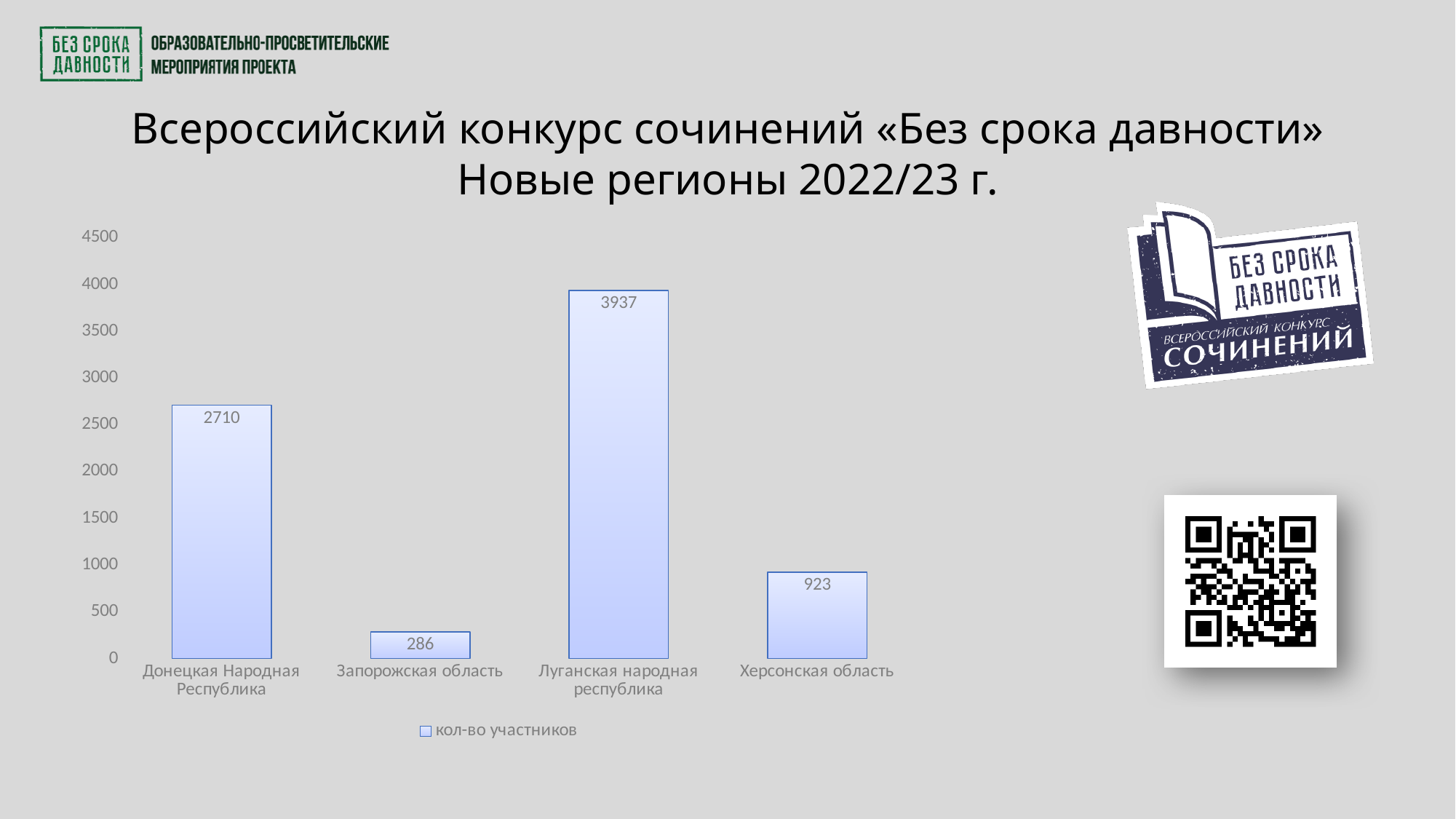
How many regions are shown in the chart? 4 What type of chart is shown on the slide? bar chart Which region has the lowest number of participants? Запорожская область Is the value for Донецкая Народная Республика greater or less than 2500? greater What is the number of participants for Запорожская область? 286 What is the difference in participants between Луганская народная республика and Донецкая Народная Республика? 1227 What is the number of participants for Луганская народная республика? 3937 What is the number of participants for Донецкая Народная Республика? 2710 Which region has the highest number of participants? Луганская народная республика Which has more participants, Херсонская область or Запорожская область? Херсонская область What series name does the legend show? кол-во участников What is the number of participants for Херсонская область? 923